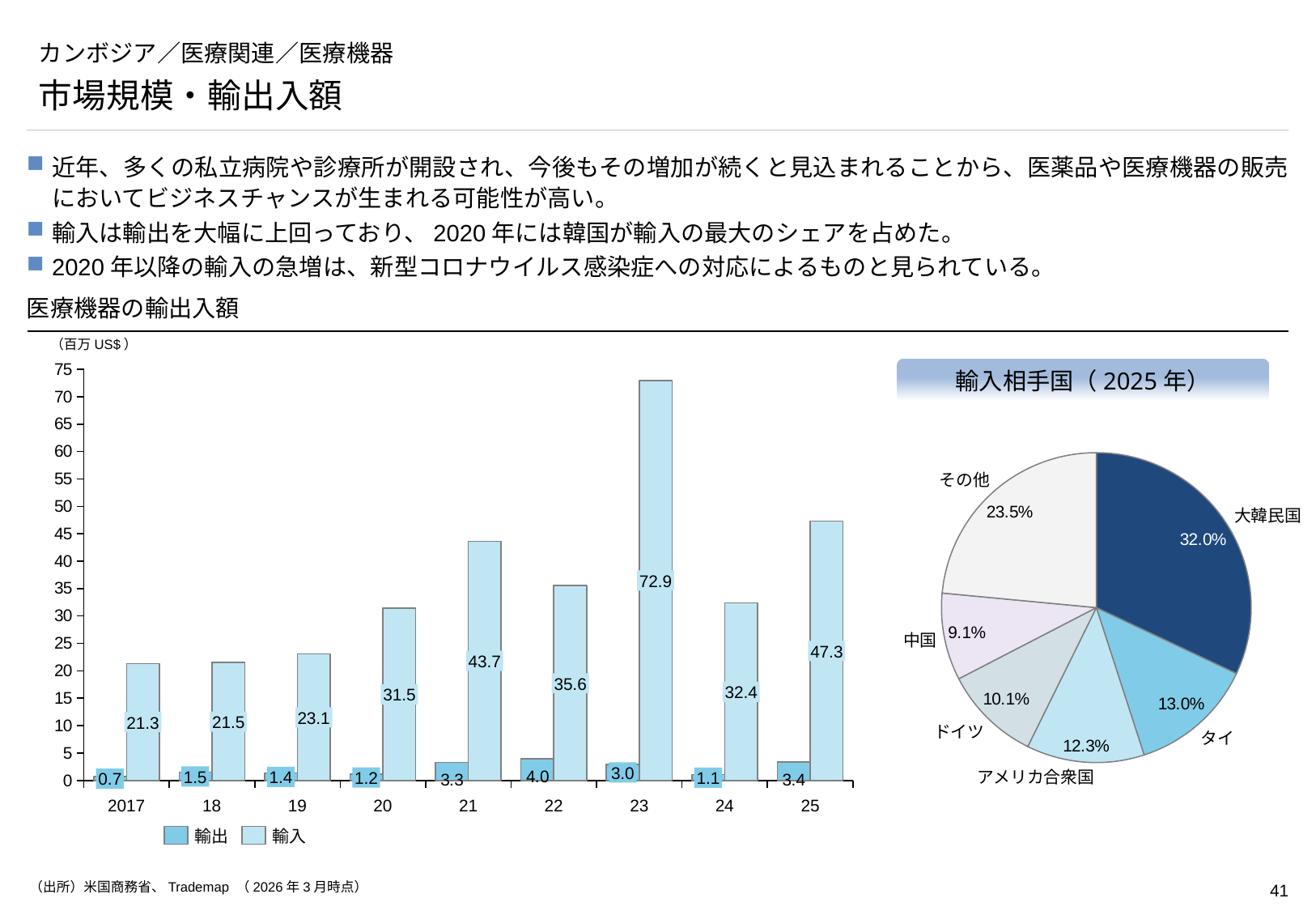
「医療機器の輸出入額」のグラフで、2022年の輸出の値はいくらですか？ 4.0 「輸入相手国（2025年）」の円グラフで、ドイツと中国ではどちらのシェアが大きいですか？ ドイツ 「医療機器の輸出入額」のグラフで、2017年から2021年にかけて輸入は増加していますか、減少していますか？ 増加 「医療機器の輸出入額」のグラフで、輸出が最も少ない年はどれですか？ 2017年 「医療機器の輸出入額」のグラフで、輸入が最も多い年はどれですか？ 2023年 「輸入相手国（2025年）」の円グラフで、大韓民国のシェアは何％ですか？ 32.0% 「医療機器の輸出入額」のグラフで、凡例にはいくつの系列がありますか？ 2 「医療機器の輸出入額」のグラフで、2021年の輸入と2022年の輸入ではどちらが大きいですか？ 2021年 「医療機器の輸出入額」のグラフで、2025年の輸入と輸出の差はいくらですか？ 43.9 「医療機器の輸出入額」のグラフで、2023年の輸入の値はいくらですか？ 72.9 「輸入相手国（2025年）」の円グラフには、いくつの区分がありますか？ 6 「医療機器の輸出入額」のグラフは何種類のグラフですか？ 棒グラフ